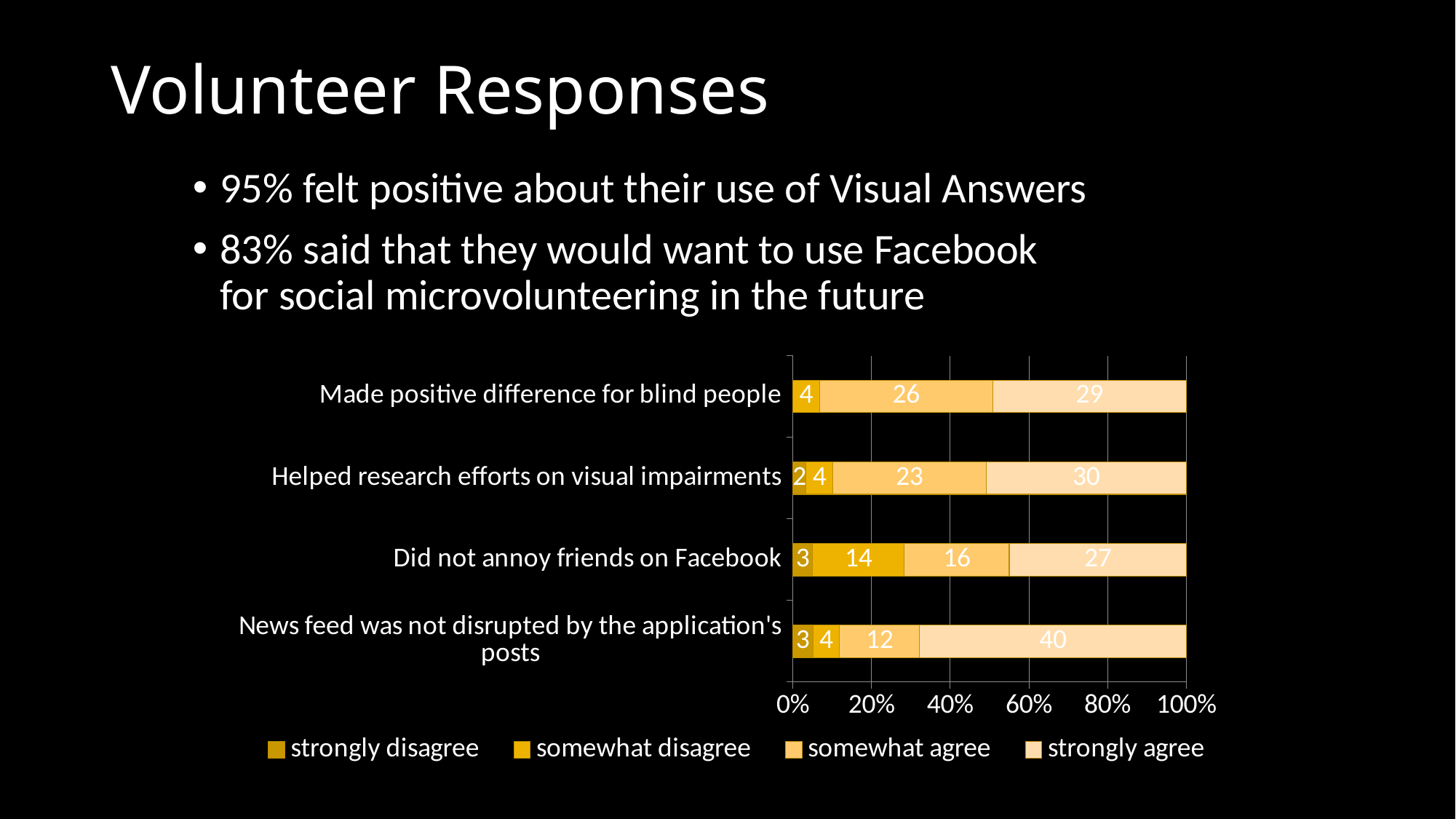
What is the strongly agree value for "News feed was not disrupted by the application's posts"? 40 Which category has the highest strongly agree value? News feed was not disrupted by the application's posts Which category has the lowest strongly agree value? Did not annoy friends on Facebook Which has the larger somewhat agree value: "Made positive difference for blind people" or "Helped research efforts on visual impairments"? Made positive difference for blind people How many categories are shown in the chart? 4 How many series does the legend list? 4 What is the somewhat agree value for "Made positive difference for blind people"? 26 What kind of chart is shown on the slide? Stacked bar chart Which series is listed last in the legend? strongly agree What is the somewhat disagree value for "Did not annoy friends on Facebook"? 14 What is the strongly disagree value for "Helped research efforts on visual impairments"? 2 What is the difference between the strongly agree values for "News feed was not disrupted by the application's posts" and "Did not annoy friends on Facebook"? 13